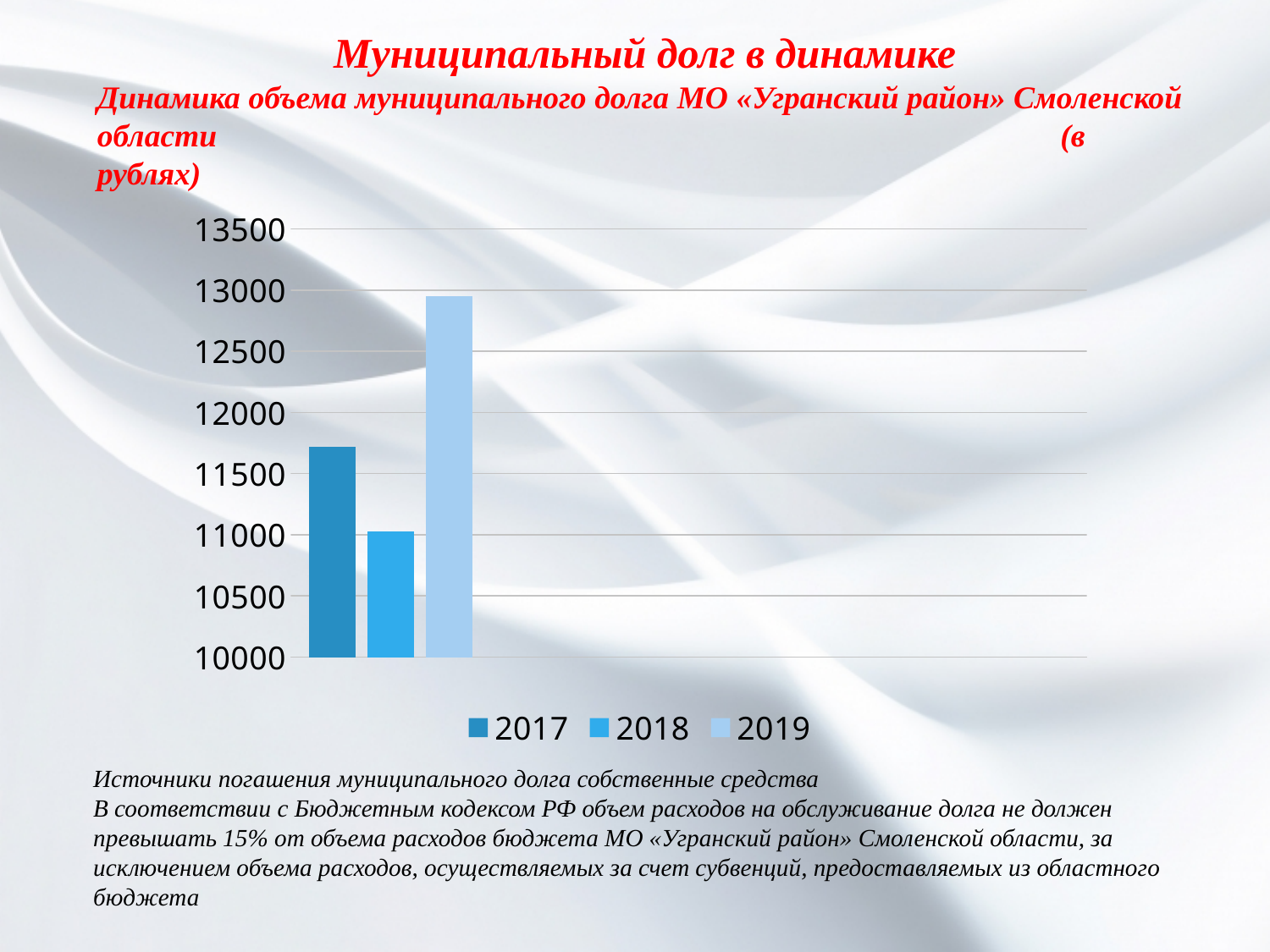
Which year has the lowest municipal debt value in the chart? 2018 Is the value for 2018 greater or less than 11500? less Is the value for 2017 greater or less than 11500? greater How many series does the chart legend list? 3 Which year has the highest municipal debt value in the chart? 2019 How many bars are plotted in the chart? 3 Does the value fall or rise from 2018 to 2019? rise Which is larger, the value for 2017 or the value for 2018? 2017 What kind of chart is shown on the slide? bar chart Which is larger, the value for 2019 or the value for 2017? 2019 What are the entries listed in the chart legend? 2017, 2018, 2019 Is the value for 2019 greater or less than 12500? greater